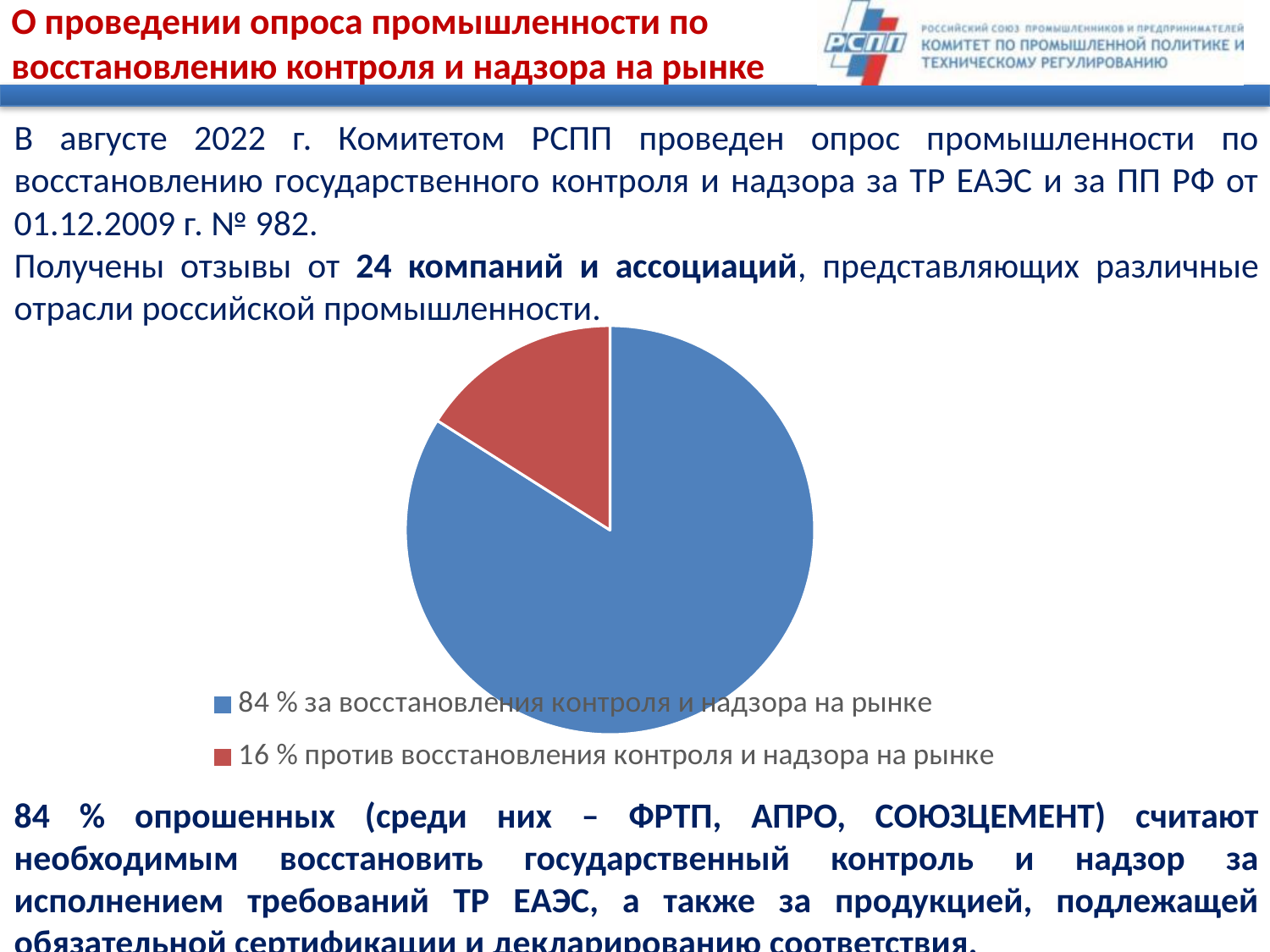
Is the share of respondents against restoring control greater or less than 20 %? less What colour is the slice representing respondents against restoring control and supervision? red What share of respondents are against restoring control and supervision on the market (против восстановления контроля и надзора на рынке)? 16 % What share of respondents are for restoring control and supervision on the market (за восстановления контроля и надзора на рынке)? 84 % How many entries does the legend of the pie chart list? 2 What is the difference in percentage points between the share for restoration and the share against restoration? 68 Which is larger: the share for restoration of control or the share against it? the share for restoration (84 %) Which slice of the pie chart is the largest? 84 % за восстановления контроля и надзора на рынке How many slices does the pie chart have? 2 What kind of chart is shown on the slide? pie chart What colour is the slice representing respondents for restoring control and supervision? blue Which slice of the pie chart is the smallest? 16 % против восстановления контроля и надзора на рынке